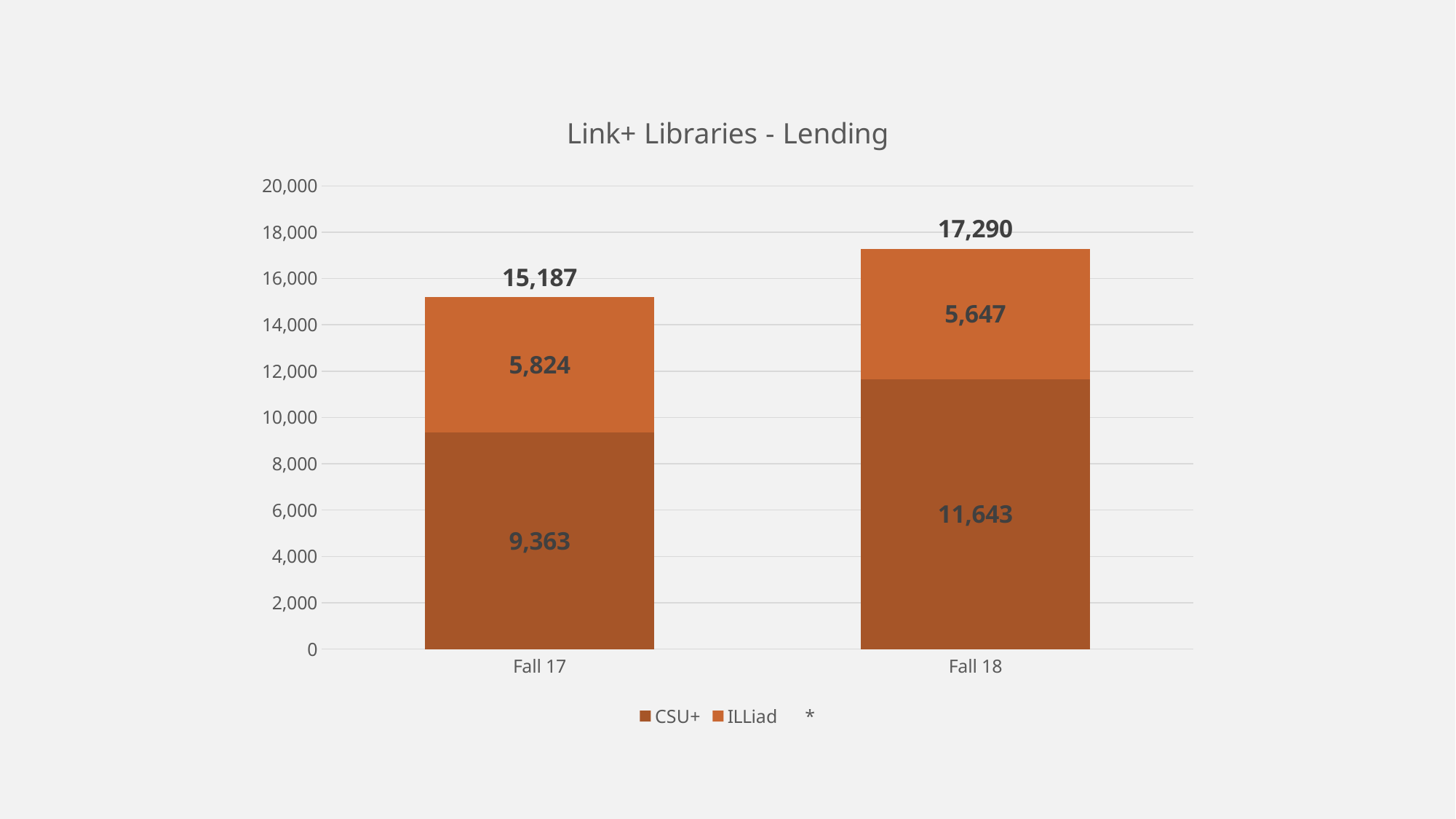
What is the ILLiad value for Fall 18? 5,647 Which series has the larger value in Fall 18, CSU+ or ILLiad? CSU+ Which period has the higher total lending, Fall 17 or Fall 18? Fall 18 By how much did the CSU+ value increase from Fall 17 to Fall 18? 2,280 What is the difference between the total for Fall 18 and the total for Fall 17? 2,103 What is the CSU+ value for Fall 18? 11,643 What is the ILLiad value for Fall 17? 5,824 What is the CSU+ value for Fall 17? 9,363 What is the title of the chart? Link+ Libraries - Lending What kind of chart is shown on the slide? Stacked bar chart What is the total of the stacked bar for Fall 18? 17,290 What is the total of the stacked bar for Fall 17? 15,187